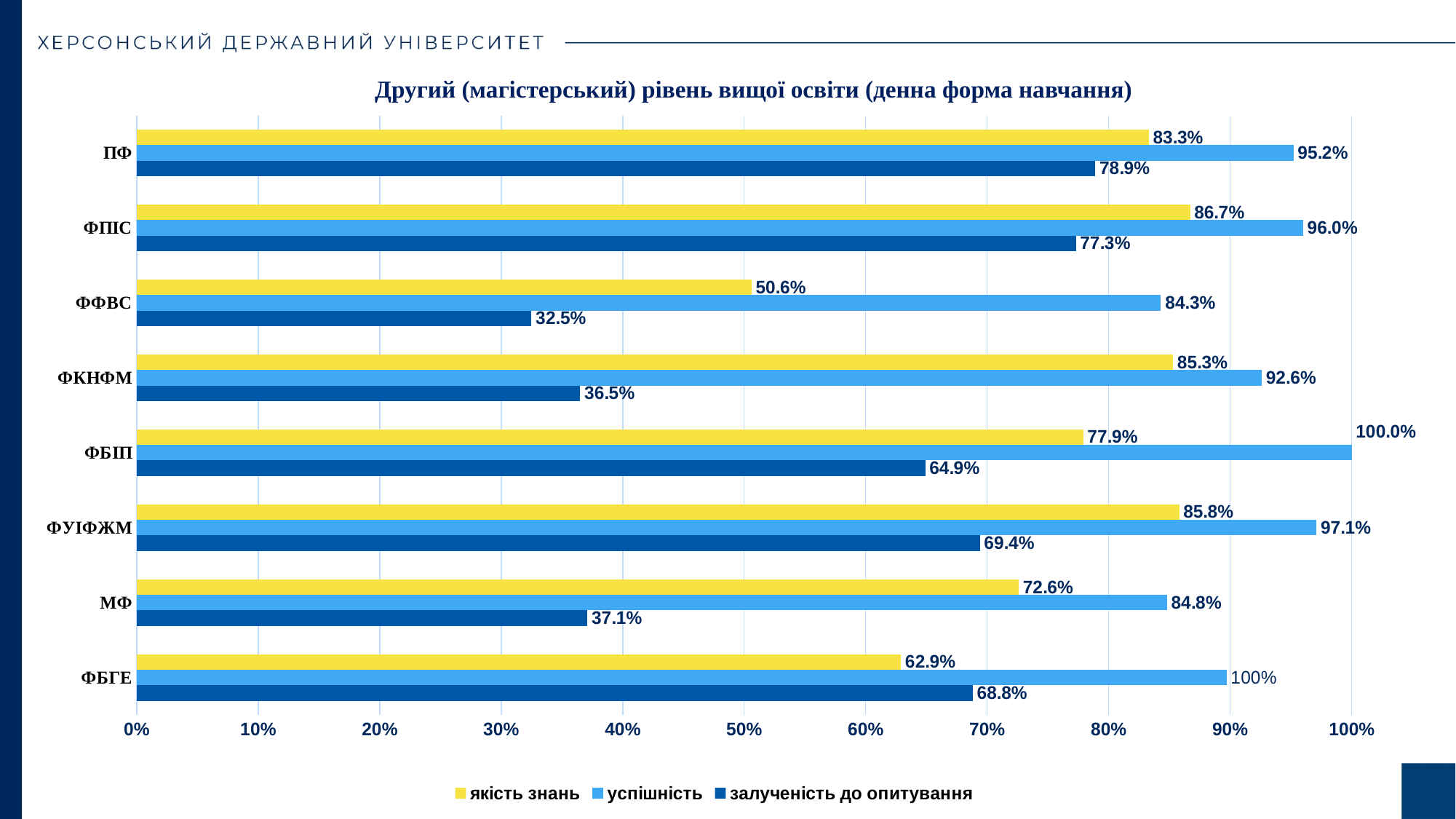
Which is larger for МФ: якість знань or залученість до опитування? якість знань What is the value of залученість до опитування for ФКНФМ? 36.5% How many faculties (categories) are shown on the chart? 8 What kind of chart is shown on the slide? bar chart What is the difference between успішність and якість знань for ПФ? 11.9% What is the value of успішність for ФПІС? 96.0% What is the value of якість знань for ФФВС? 50.6% Is the value of залученість до опитування for ФБІП greater or less than 60%? greater Which faculty has the highest value of якість знань? ФПІС What is the title of the chart? Другий (магістерський) рівень вищої освіти (денна форма навчання) Which faculty has the lowest value of залученість до опитування? ФФВС How many series does the legend list? 3